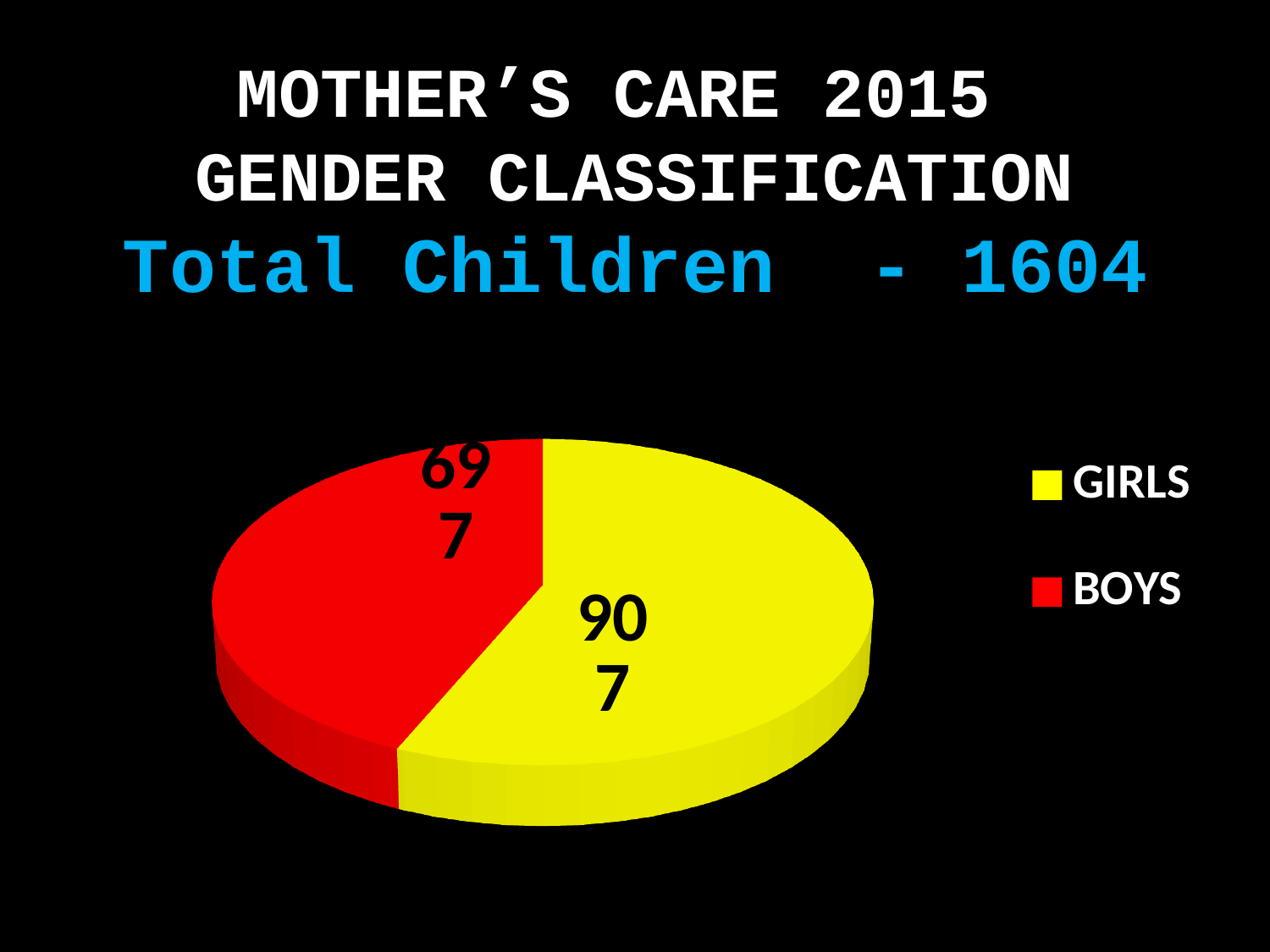
How many entries does the legend list? 2 What colour is the GIRLS slice in the pie chart? Yellow How many categories are shown in the pie chart? 2 What year is given in the slide title? 2015 Which is larger, the value for GIRLS or the value for BOYS? GIRLS What is the difference between the number of GIRLS and the number of BOYS? 210 Which category has the largest slice of the pie chart? GIRLS Which category has the smallest slice of the pie chart? BOYS What kind of chart is shown on the slide? Pie chart What is the value for GIRLS in the pie chart? 907 What is the value for BOYS in the pie chart? 697 What is the total number of children shown on the slide? 1604